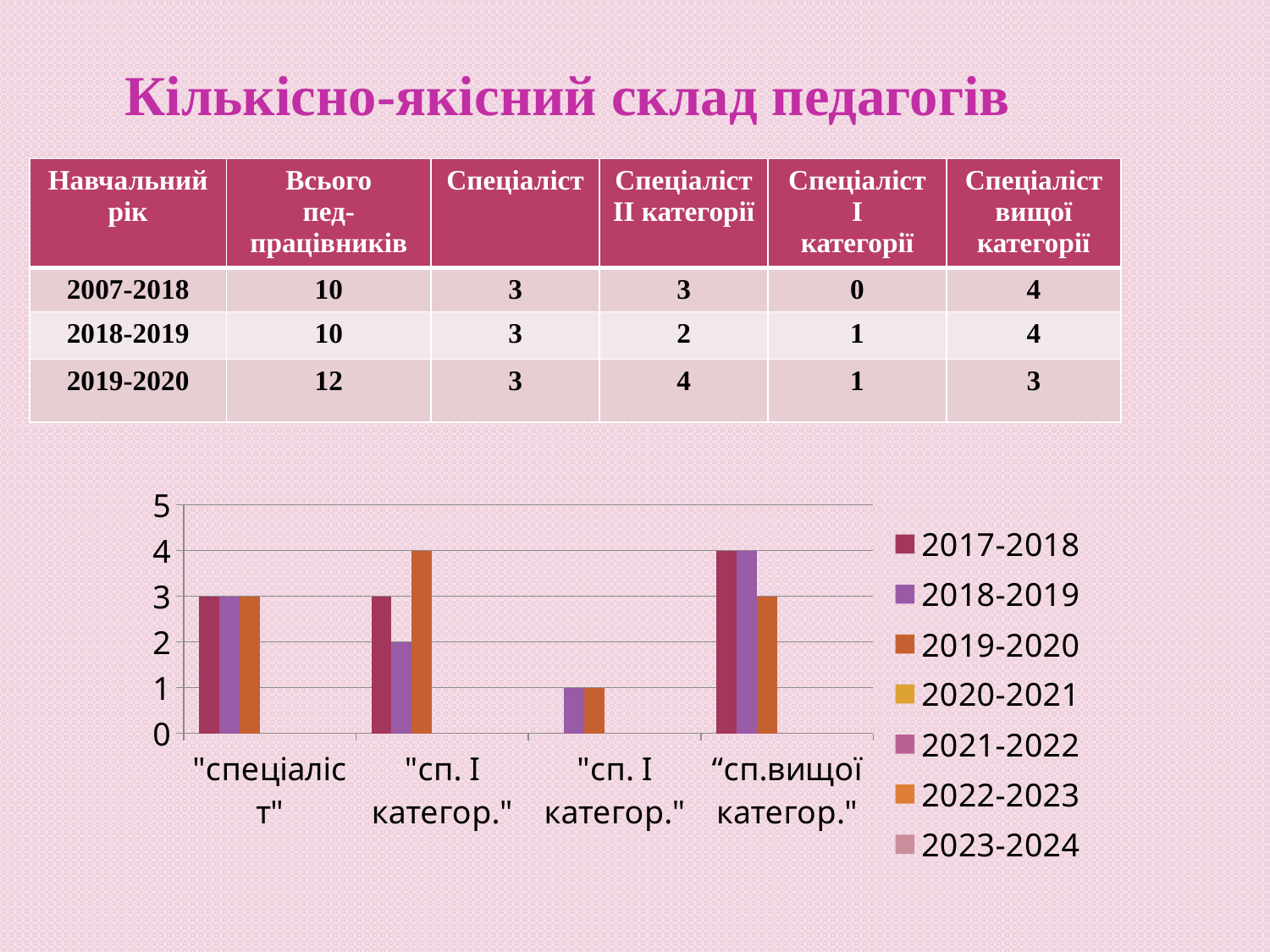
How many series does the chart legend list? 7 What is the title of the slide? Кількісно-якісний склад педагогів Is the value for the 2019-2020 series in the second category from the left greater or less than 3? greater What kind of chart is shown on the slide? bar chart In the "сп.вищої категор." category, which series has the lowest value? 2019-2020 What is the value for the 2019-2020 series in the "сп.вищої категор." category? 3 What is the value for the 2018-2019 series in the "спеціаліст" category? 3 How many of the legend series actually have bars plotted in the chart? 3 What is the value for the 2017-2018 series in the "сп.вищої категор." category? 4 In the "сп.вищої категор." category, what is the difference between the 2017-2018 value and the 2019-2020 value? 1 How many categories are shown on the x axis of the chart? 4 In the second category from the left, which is larger: the 2018-2019 bar or the 2019-2020 bar? 2019-2020